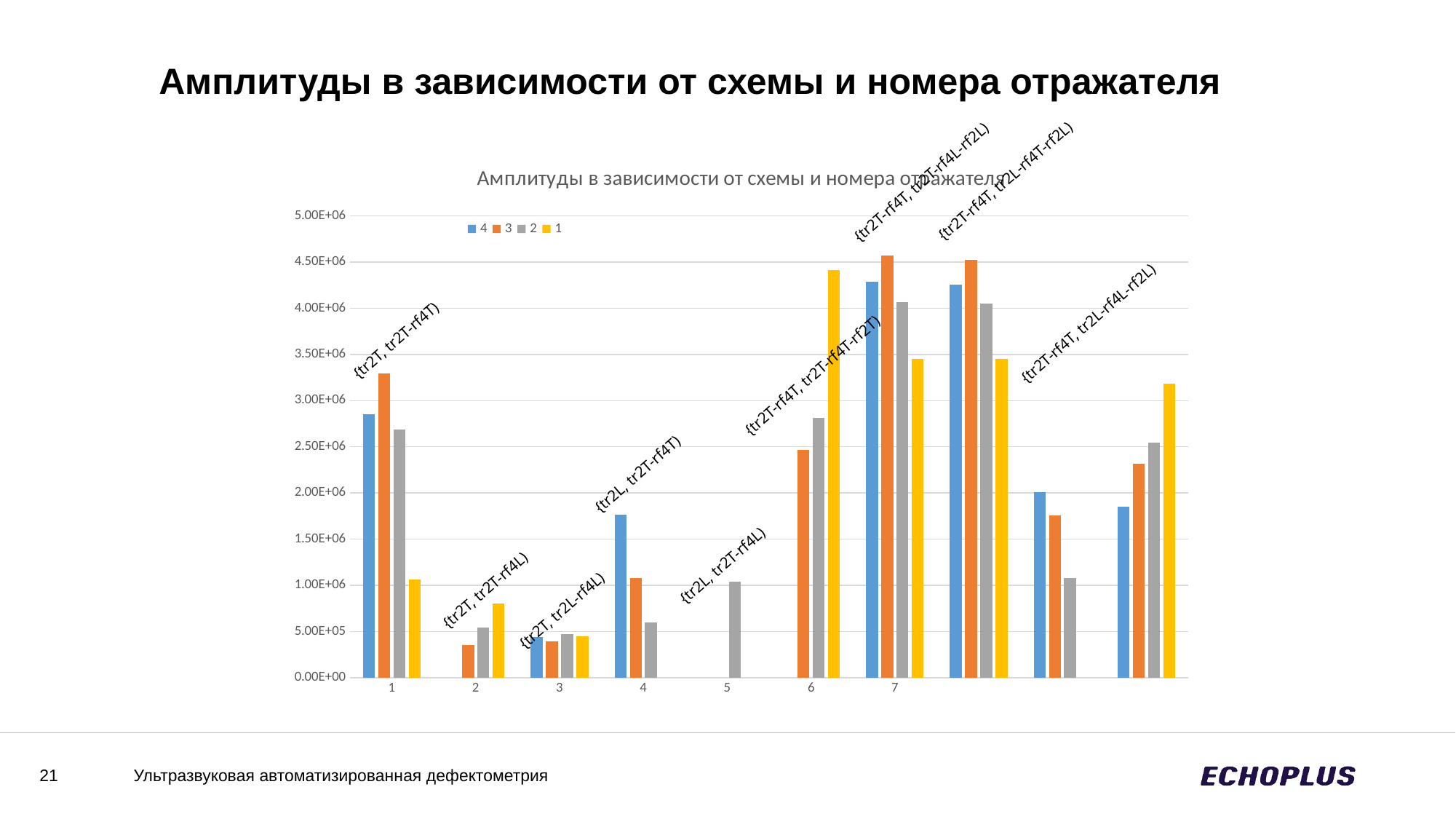
Is the value for series 4 at category 4 greater or less than 1.50E+06? greater How many series does the legend list? 4 Is the value for series 3 at category 1 greater or less than 3.00E+06? greater What kind of chart is shown on the slide? bar chart Is the value for series 3 at category 2 greater or less than 5.00E+05? less What is the title of the chart? Амплитуды в зависимости от схемы и номера отражателя At category 5, which series is the only one with a visible bar? 2 At category 1, which is larger: the value for series 3 or the value for series 1? series 3 What are the legend entries of the chart? 4, 3, 2, 1 At category 6, which series has the highest value? 1 At category 1, which series has the lowest value? 1